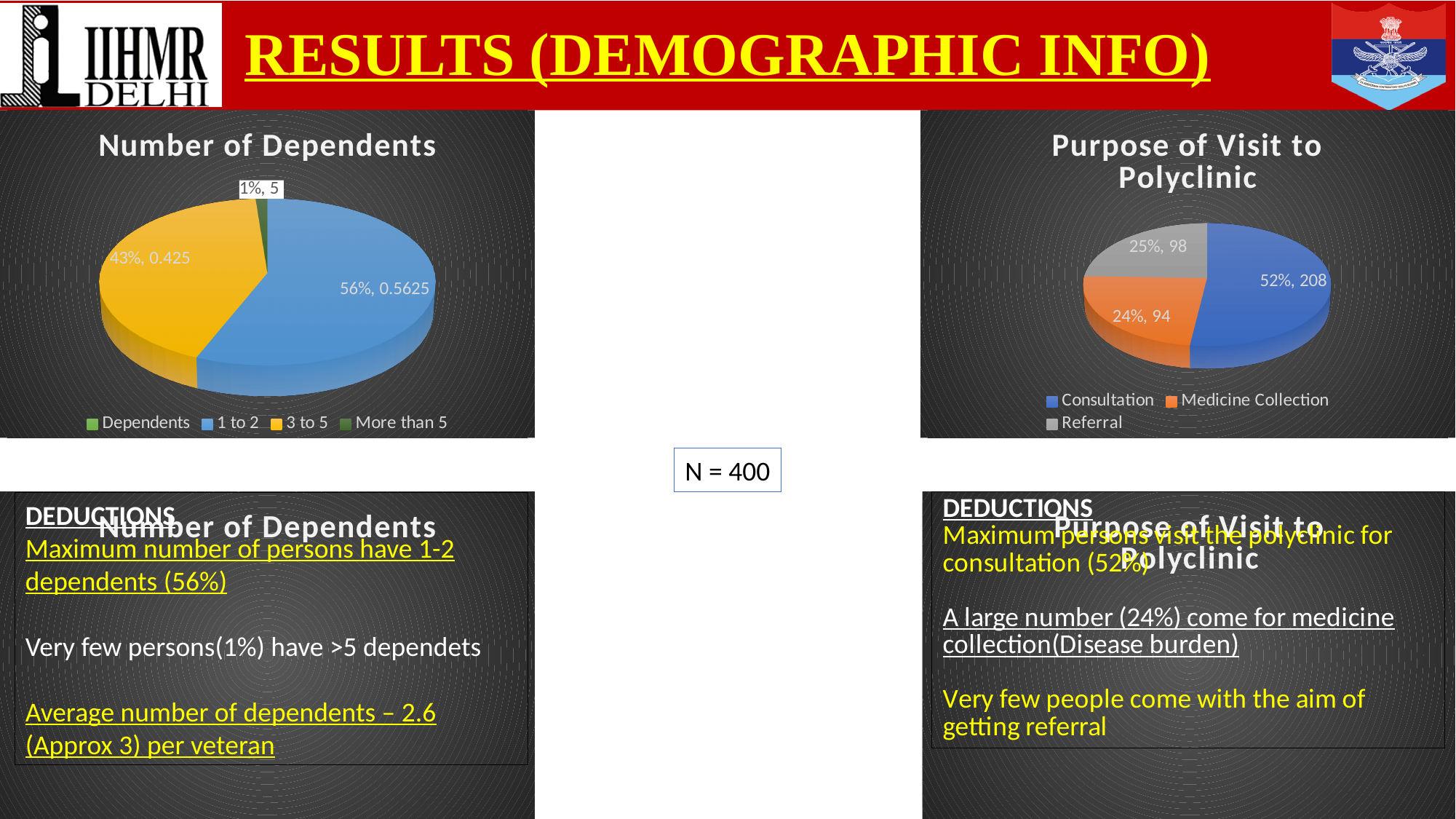
What kind of chart is the "Number of Dependents" chart? Pie chart In the "Purpose of Visit to Polyclinic" chart, what is the difference between the Consultation value and the Referral value? 110 In the "Purpose of Visit to Polyclinic" chart, what percentage share is shown for Referral? 25% In the "Number of Dependents" chart, what percentage share is shown for the More than 5 slice? 1% In the "Number of Dependents" chart, which category has the largest slice? 1 to 2 In the "Purpose of Visit to Polyclinic" chart, what value is shown for Medicine Collection? 94 In the "Number of Dependents" chart, what percentage share is shown for the 1 to 2 slice? 56% In the "Purpose of Visit to Polyclinic" chart, which is larger, the Consultation value or the Medicine Collection value? Consultation How many entries does the legend of the "Purpose of Visit to Polyclinic" chart list? 3 In the "Purpose of Visit to Polyclinic" chart, what value is shown for Consultation? 208 In the "Number of Dependents" chart, which category has the smallest slice? More than 5